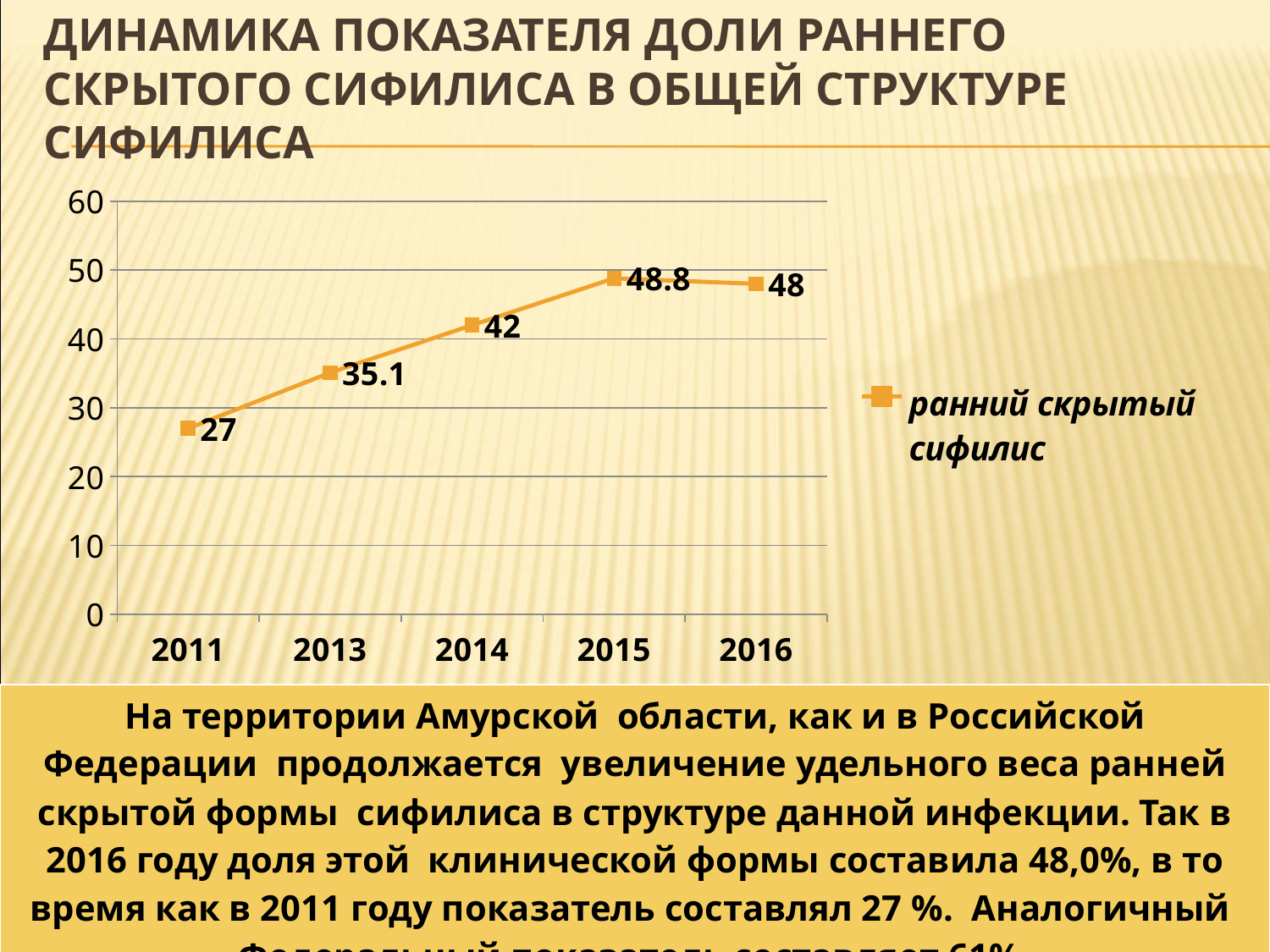
What is the value for 2013? 35.1 What is the difference between the values for 2014 and 2011? 15 Which year has the lowest value? 2011 Which is larger, the value for 2013 or the value for 2014? 2014 How many years are plotted on the x axis? 5 What is the value for 2016? 48 What is the name of the series in the legend? ранний скрытый сифилис Which year has the highest value? 2015 What kind of chart is shown? line chart How many series does the legend list? 1 What is the value for 2011? 27 What is the value for 2015? 48.8